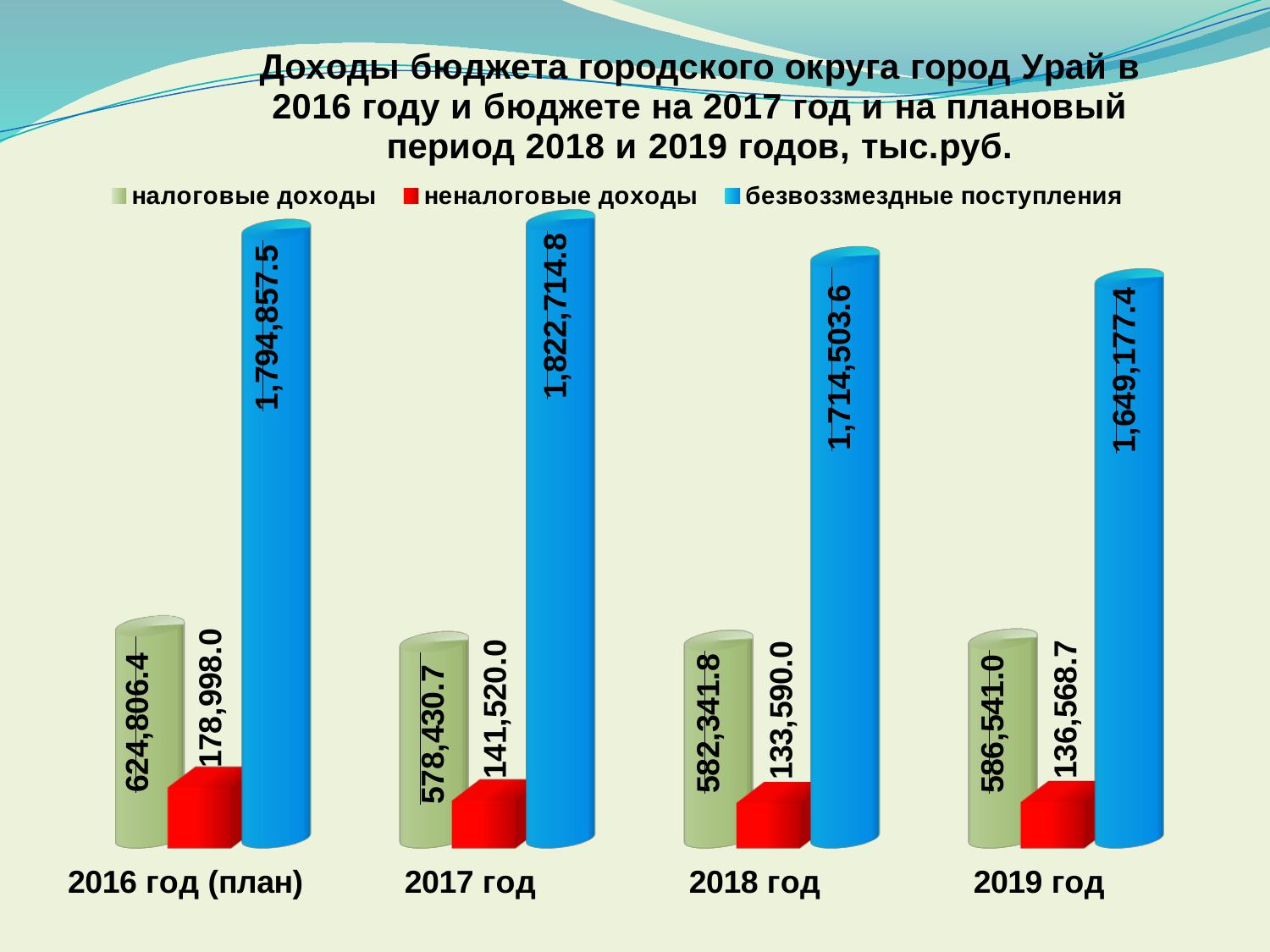
Which is larger: налоговые доходы in 2018 год or in 2019 год? 2019 год How many series does the legend list? 3 What is the difference between безвозмездные поступления in 2017 год and in 2016 год (план)? 27,857.3 How many year categories are shown on the x axis? 4 In which year is безвозмездные поступления the lowest? 2019 год In which year is безвозмездные поступления the highest? 2017 год What is the value of безвозмездные поступления for 2017 год? 1,822,714.8 Does безвозмездные поступления rise or fall from 2017 год to 2019 год? fall What is the value of неналоговые доходы for 2019 год? 136,568.7 What type of chart is shown on the slide? bar chart What is the value of налоговые доходы for 2016 год (план)? 624,806.4 In which year is неналоговые доходы the lowest? 2018 год